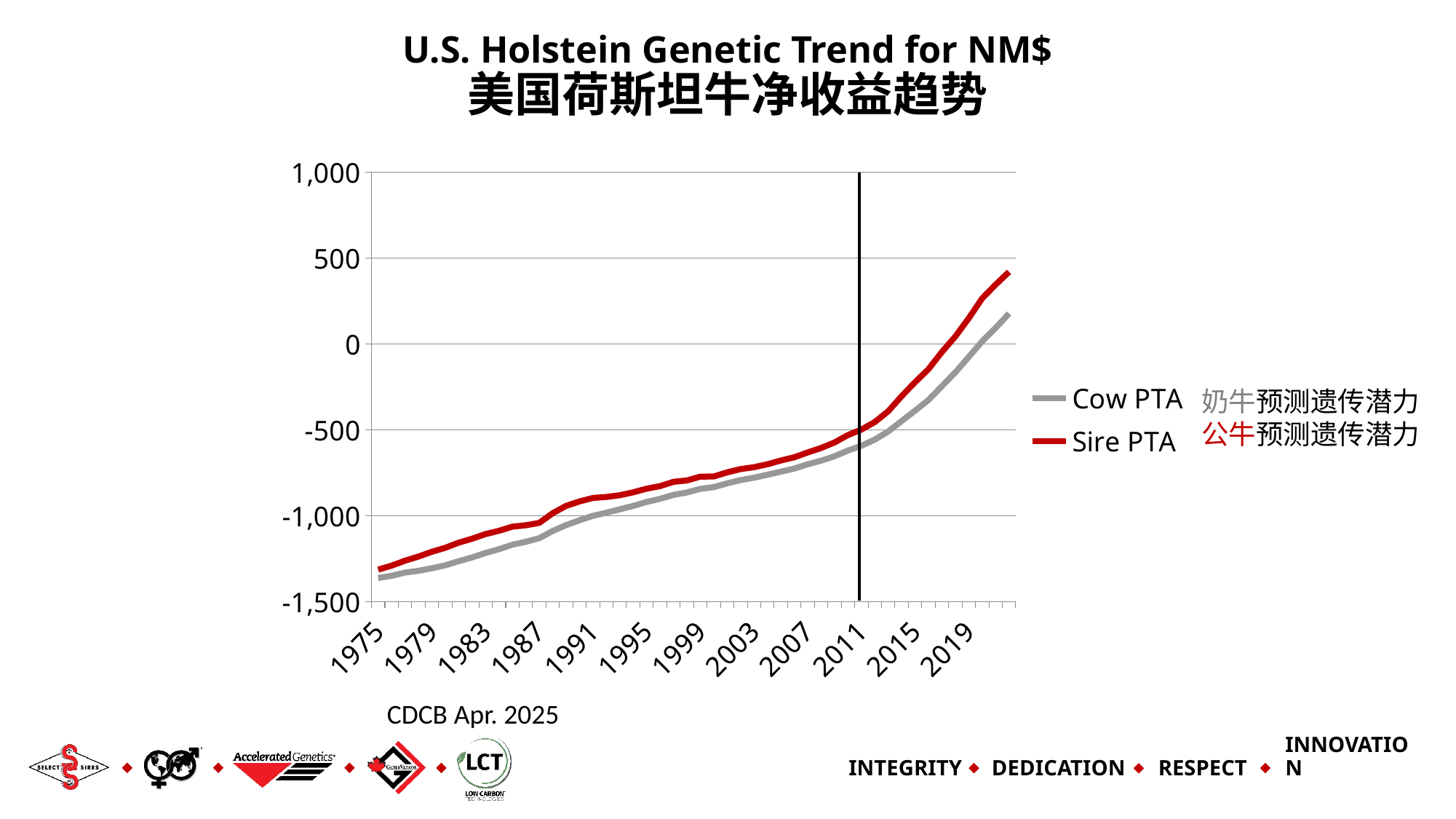
How many year labels are shown on the x axis? 12 Do the Sire PTA values rise or fall from 1975 to the end of the series? rise Is the Cow PTA value in 1975 greater or less than -1,000? less What colour is the Sire PTA line? red What kind of chart is shown on the slide? line chart Is the Sire PTA value at the last point of the series greater or less than 0? greater In 2015, which series has the larger value, Cow PTA or Sire PTA? Sire PTA How many series does the legend list? 2 Is the Cow PTA value in 2019 greater or less than -500? greater Do the Cow PTA values rise or fall along the x axis? rise In 1983, which series has the lower value, Cow PTA or Sire PTA? Cow PTA